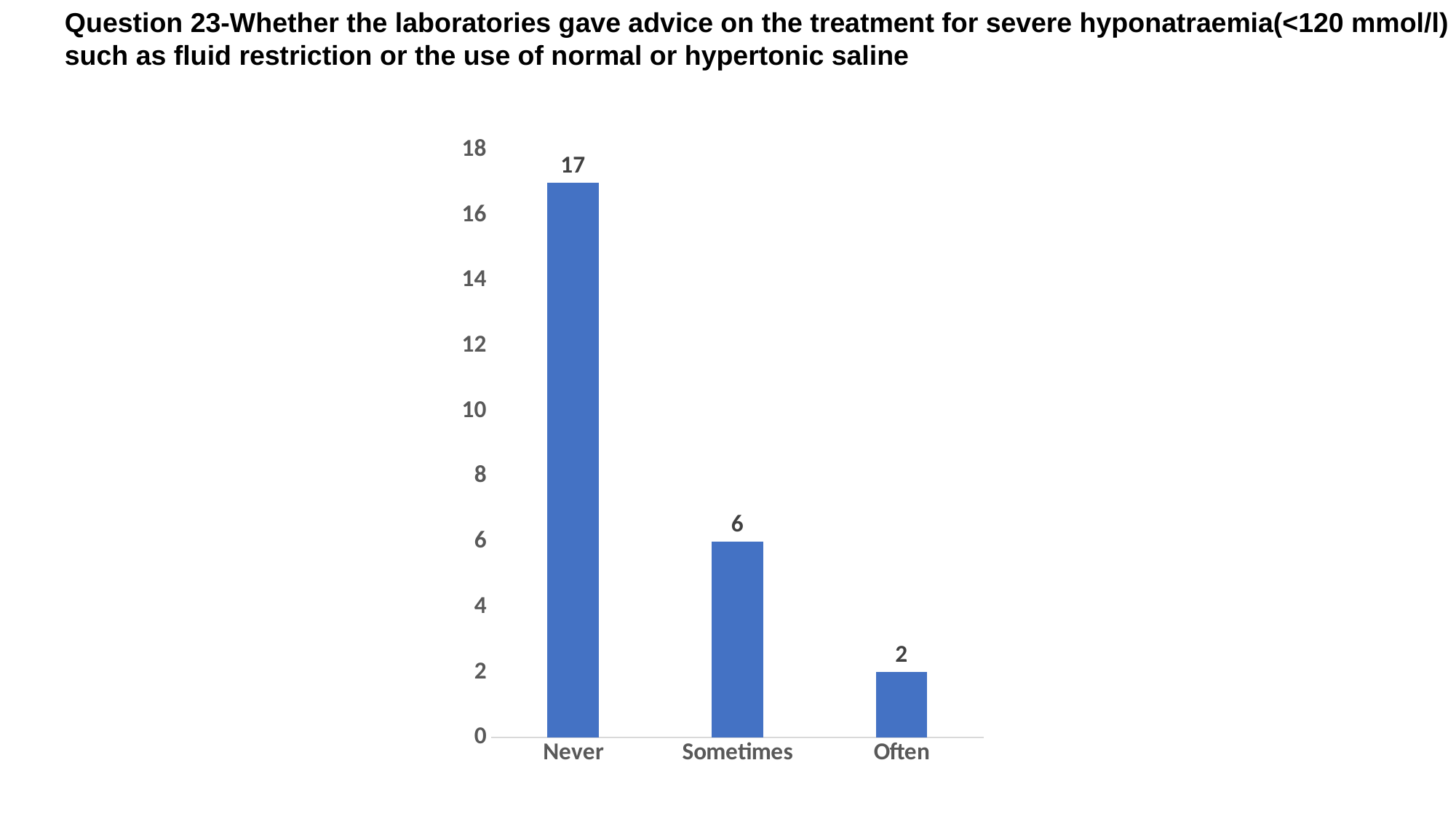
What kind of chart is shown on the slide? bar chart What is the difference between the values for Never and Sometimes? 11 Which is larger, the value for Sometimes or the value for Often? Sometimes Is the value for Never greater or less than 10? greater What is the difference between the values for Sometimes and Often? 4 Which category has the highest value? Never What is the value for Never? 17 Which category has the lowest value? Often What is the value for Sometimes? 6 Do the values rise or fall from Never to Often along the x axis? fall What is the value for Often? 2 How many categories are shown on the x axis? 3